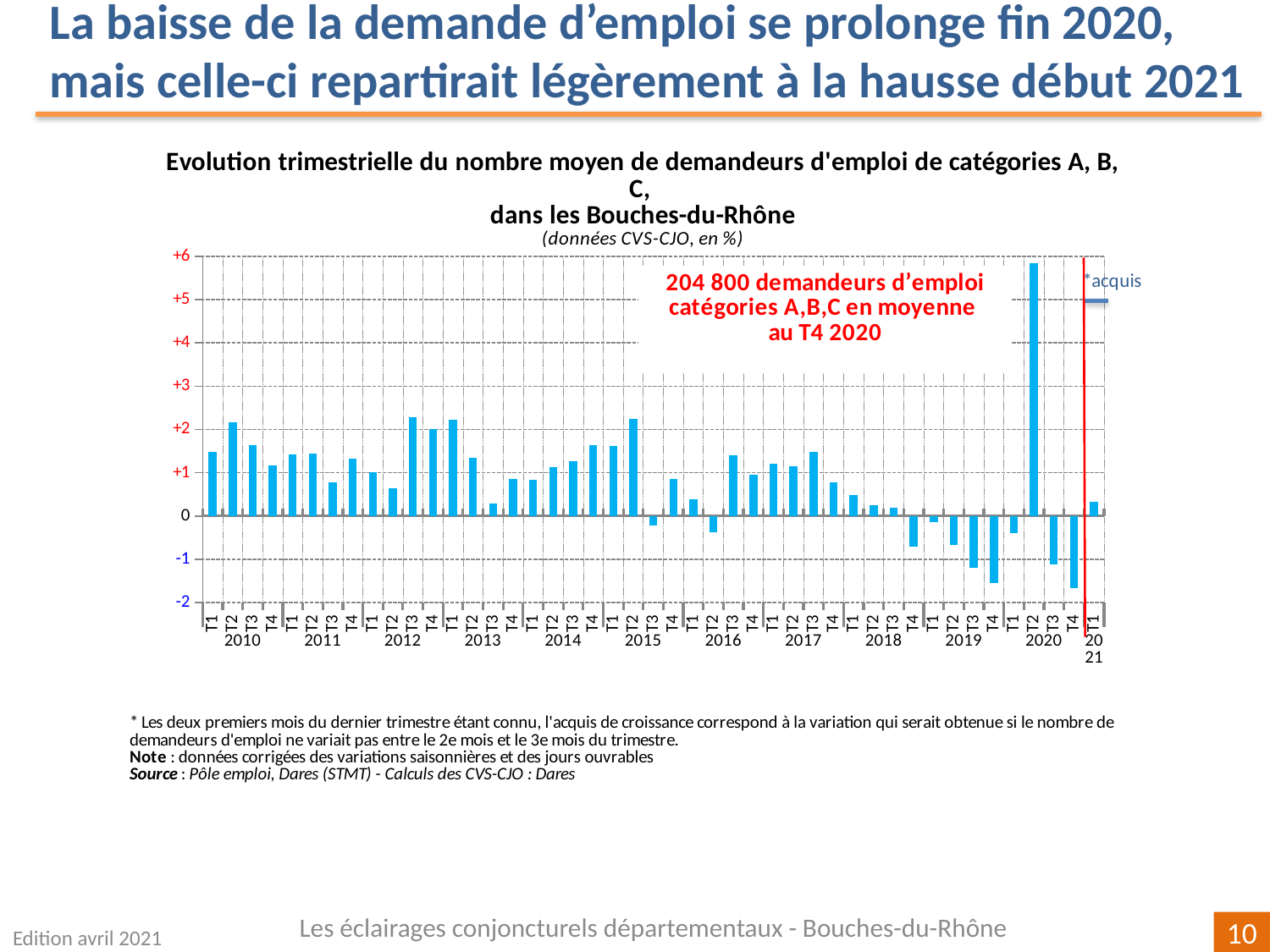
Is the value for T2 2020 greater or less than +5? greater According to the annotation on the chart, what was the average number of demandeurs d'emploi catégories A,B,C in T4 2020? 204 800 Is the value for T4 2019 greater or less than -1? less Is the value for T1 2021 greater or less than 0? greater What kind of chart is shown on the slide? bar chart Which quarter has the highest value in the chart? T2 2020 Which is larger, the value for T2 2010 or the value for T4 2010? T2 2010 Do the values rise or fall across the four quarters of 2019 (T1 to T4)? fall How many years are labelled on the x axis of the chart? 12 Which is larger, the value for T3 2012 or the value for T3 2013? T3 2012